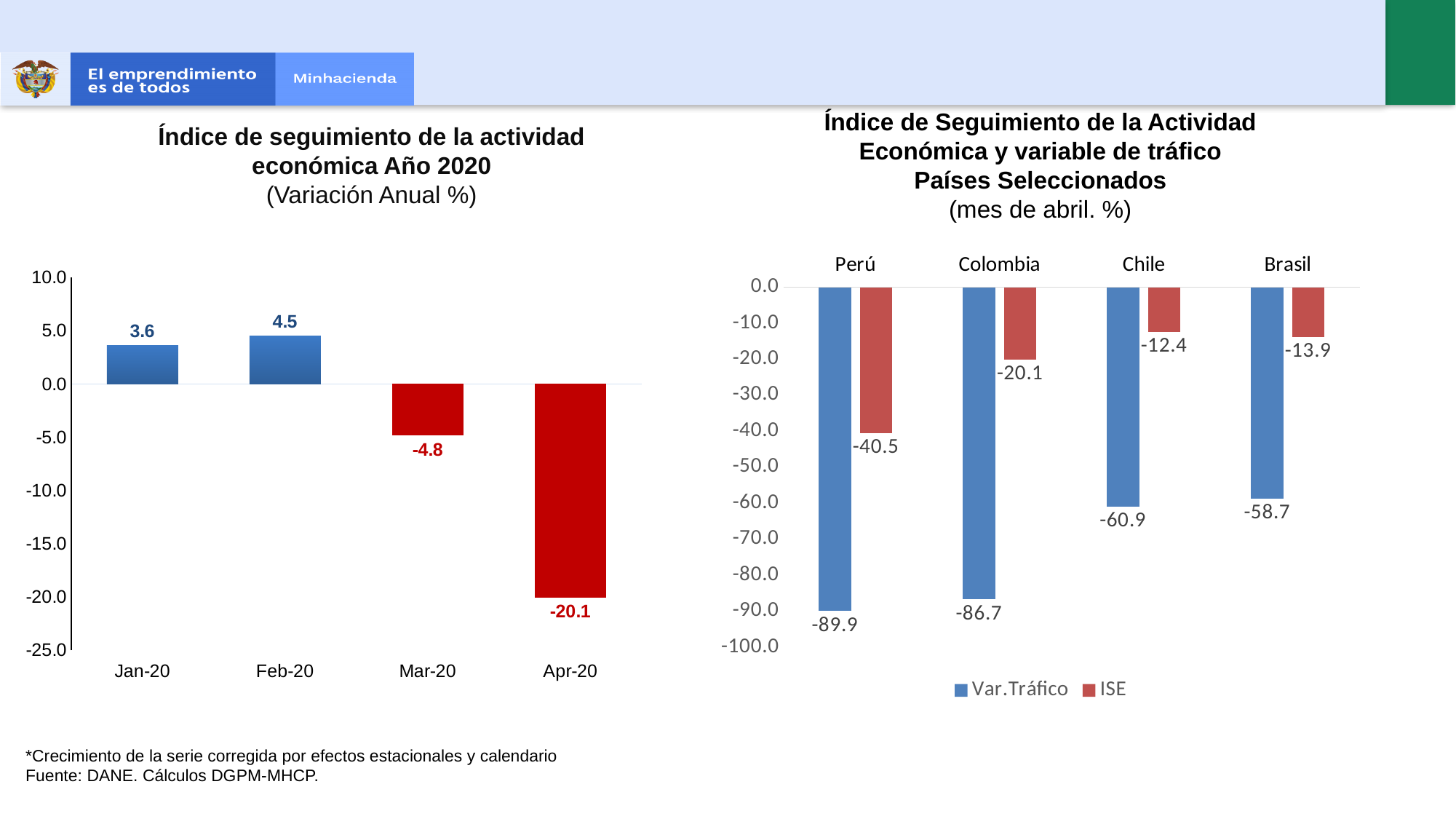
In the right chart (Índice de Seguimiento de la Actividad Económica y variable de tráfico), what is the Var.Tráfico value for Perú? -89.9 In the left chart (Índice de seguimiento de la actividad económica Año 2020), what is the difference between the Feb-20 and Jan-20 values? 0.9 In the left chart (Índice de seguimiento de la actividad económica Año 2020), what is the value for Apr-20? -20.1 In the left chart (Índice de seguimiento de la actividad económica Año 2020), which month has the highest value? Feb-20 In the left chart (Índice de seguimiento de la actividad económica Año 2020), how many months are plotted? 4 In the right chart (Índice de Seguimiento de la Actividad Económica y variable de tráfico), is the Var.Tráfico value for Colombia larger or smaller than the Var.Tráfico value for Brasil? smaller In the right chart (Índice de Seguimiento de la Actividad Económica y variable de tráfico), which country has the lowest ISE value? Perú In the right chart (Índice de Seguimiento de la Actividad Económica y variable de tráfico), how many series does the legend list? 2 In the left chart (Índice de seguimiento de la actividad económica Año 2020), do the values rise or fall from Jan-20 to Apr-20 overall? fall In the right chart (Índice de Seguimiento de la Actividad Económica y variable de tráfico), what is the ISE value for Chile? -12.4 In the left chart (Índice de seguimiento de la actividad económica Año 2020), what is the value for Feb-20? 4.5 In the left chart (Índice de seguimiento de la actividad económica Año 2020), which month has the lowest value? Apr-20